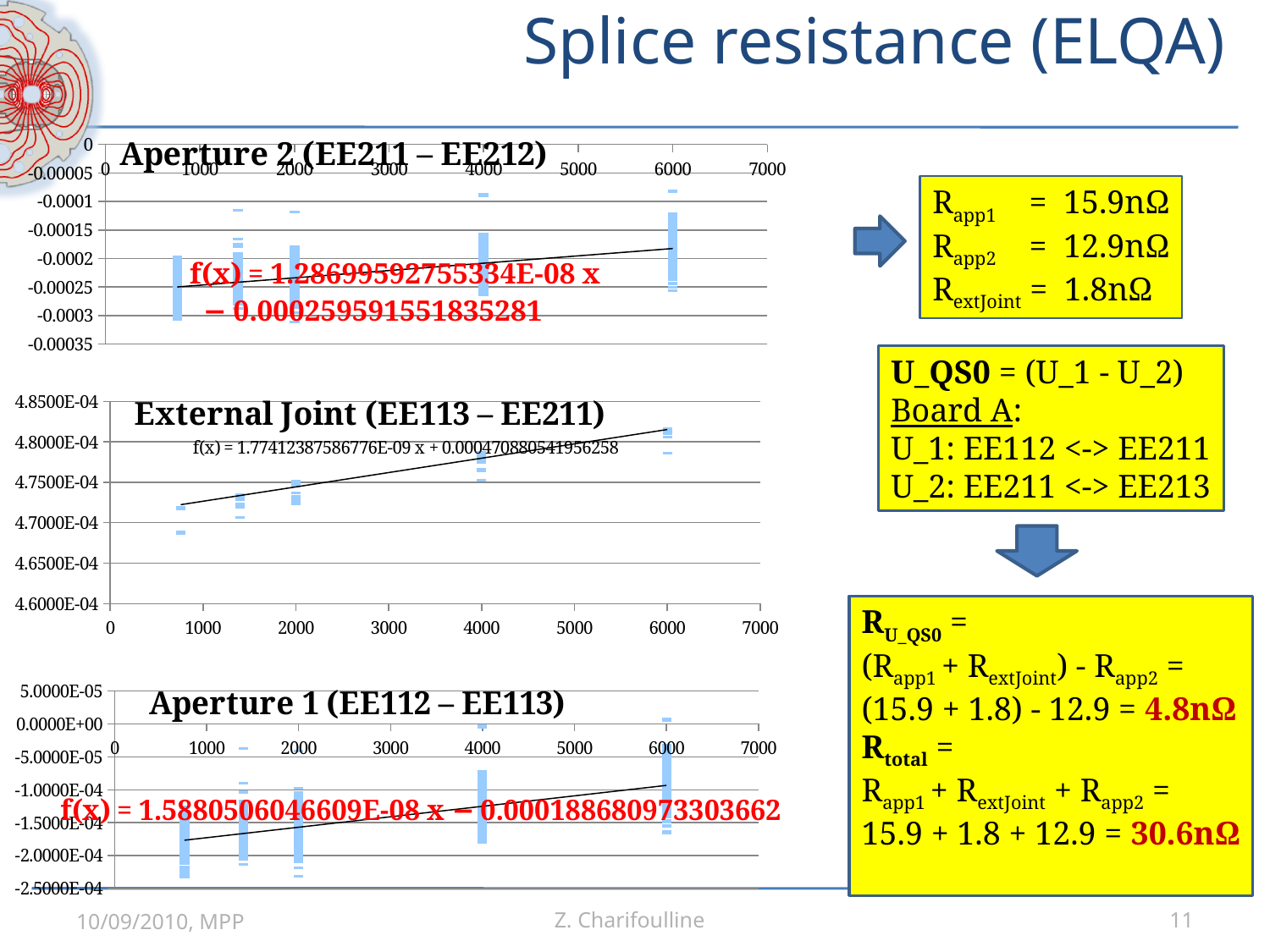
What is the trendline equation printed on the top chart, Aperture 2 (EE211 – EE212)? f(x) = 1.28699592755334E-08 x − 0.000259591551835281 What is the trendline equation printed on the middle chart, External Joint (EE113 – EE211)? f(x) = 1.77412387586776E-09 x + 0.000470880541956258 What is the title of the middle chart on the slide? External Joint (EE113 – EE211) In the middle chart, External Joint (EE113 – EE211), are the data points near x = 750 greater or less than 4.7500E-04? less What is the trendline equation printed on the bottom chart, Aperture 1 (EE112 – EE113)? f(x) = 1.5880506046609E-08 x − 0.000188680973303662 In the middle chart, External Joint (EE113 – EE211), does the fitted trendline rise or fall along the x axis? rise In the bottom chart, Aperture 1 (EE112 – EE113), does the fitted trendline rise or fall along the x axis? rise In the middle chart, External Joint (EE113 – EE211), are the data points at x = 6000 greater or less than 4.7500E-04? greater In the top chart, Aperture 2 (EE211 – EE212), does the fitted trendline rise or fall as x increases? rise What is the title of the top chart on the slide? Aperture 2 (EE211 – EE212) What kind of chart is the bottom chart, Aperture 1 (EE112 – EE113)? scatter chart What is the maximum value shown on the x axis of the middle chart, External Joint (EE113 – EE211)? 7000